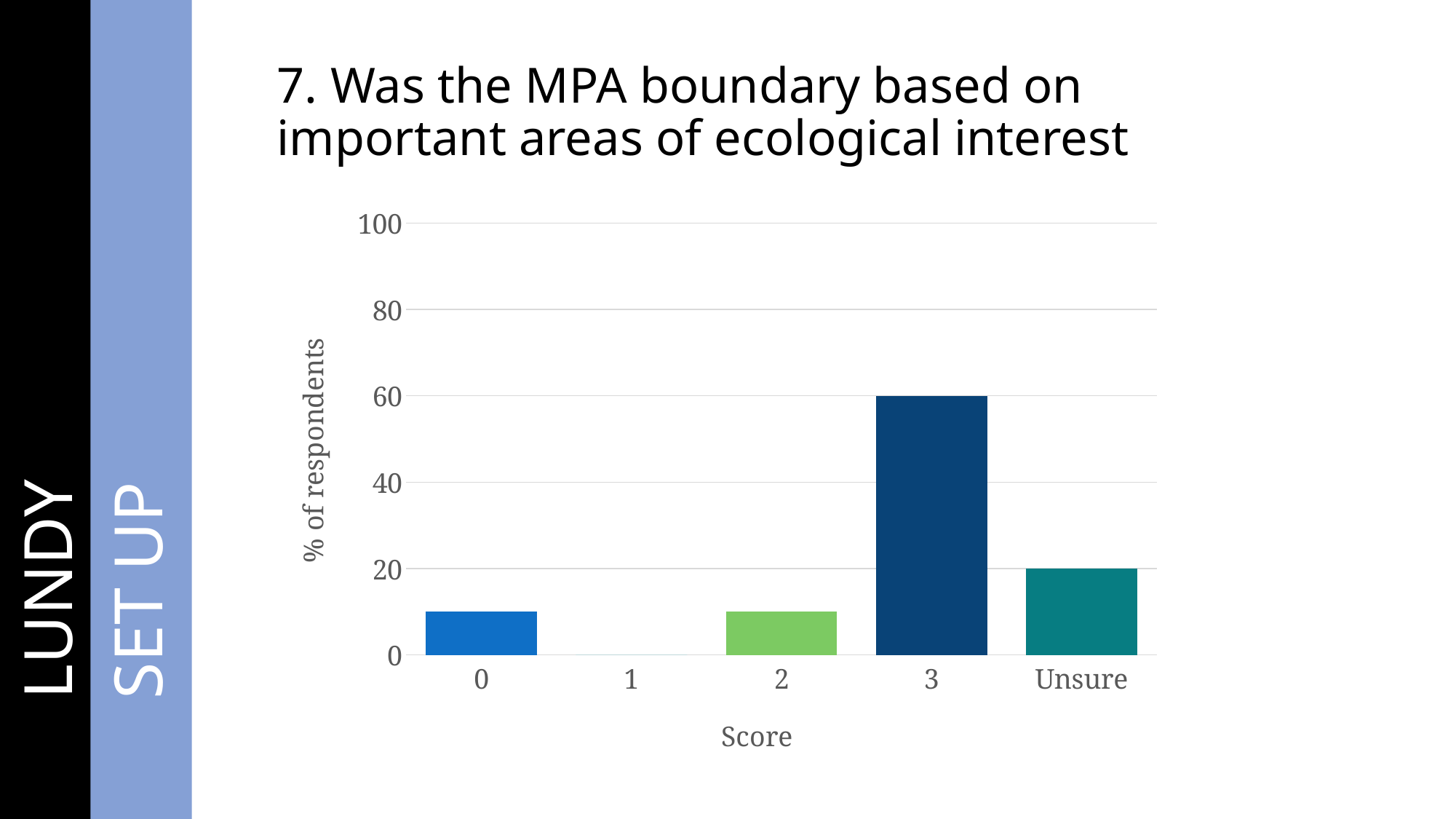
What is the label of the x axis? Score Which score category has the lowest percentage of respondents? 1 What is the label of the y axis? % of respondents Which has a larger percentage of respondents, score 3 or Unsure? 3 What percentage of respondents answered Unsure? 20 How many score categories are shown on the x axis? 5 What is the difference in percentage of respondents between score 3 and Unsure? 40 Which score category has the highest percentage of respondents? 3 What percentage of respondents gave a score of 3? 60 Is the value for score 2 greater or less than 20? less Is the value for score 0 greater or less than 20? less What kind of chart is shown on the slide? bar chart